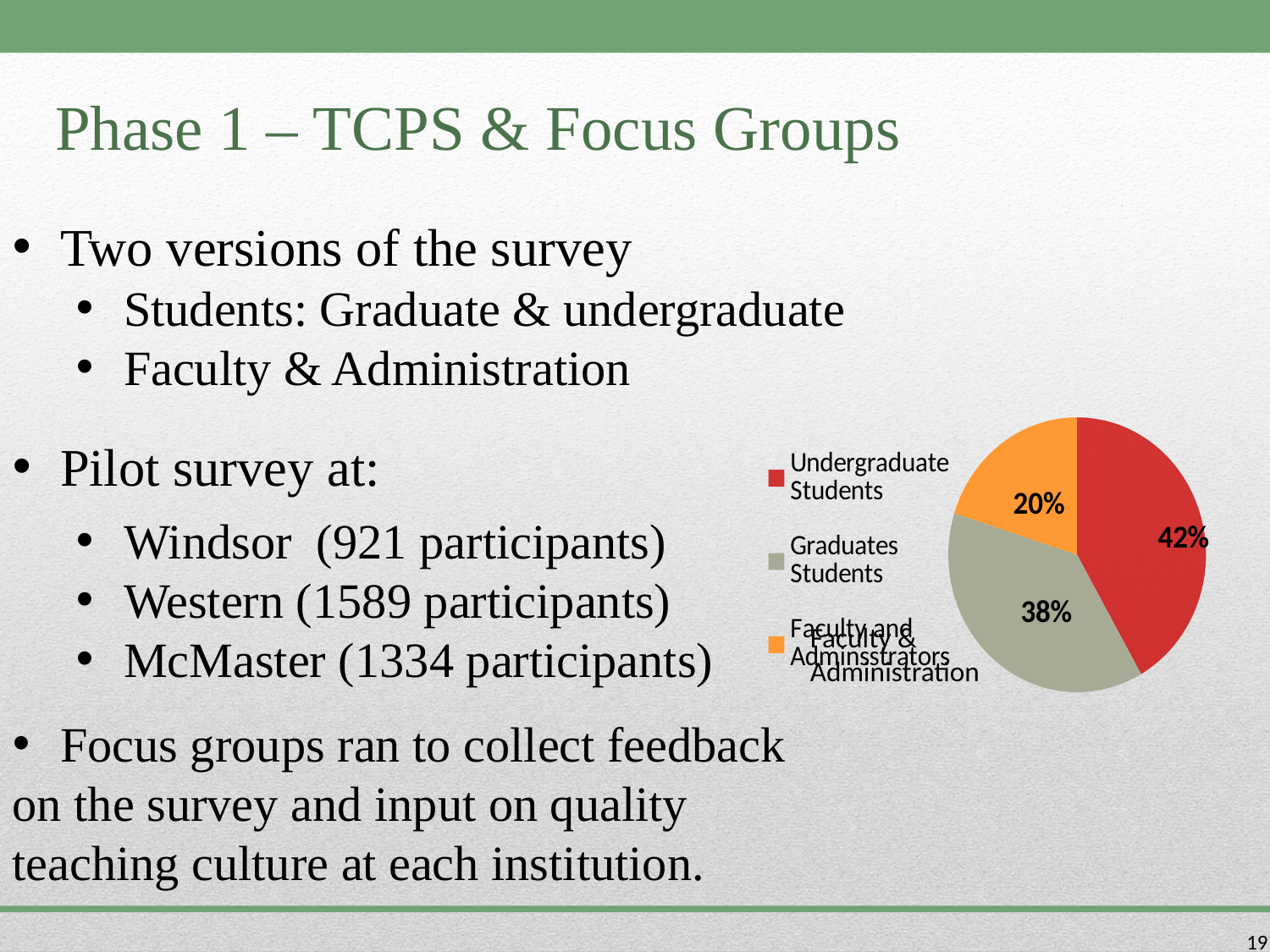
How many slices does the pie chart have? 3 What kind of chart is shown on the slide? pie chart What colour is the Undergraduate Students slice in the pie chart? red What is the difference in percentage points between the Graduates Students slice and the Faculty & Administration slice? 18 What share of the pie chart is Graduates Students? 38% What is the difference in percentage points between the Undergraduate Students slice and the Graduates Students slice? 4 Which category has the smallest slice of the pie chart? Faculty & Administration What share of the pie chart is Faculty & Administration? 20% Which category has the largest slice of the pie chart? Undergraduate Students What colour is the Faculty & Administration slice in the pie chart? orange Which is larger in the pie chart, Graduates Students or Faculty & Administration? Graduates Students What share of the pie chart is Undergraduate Students? 42%